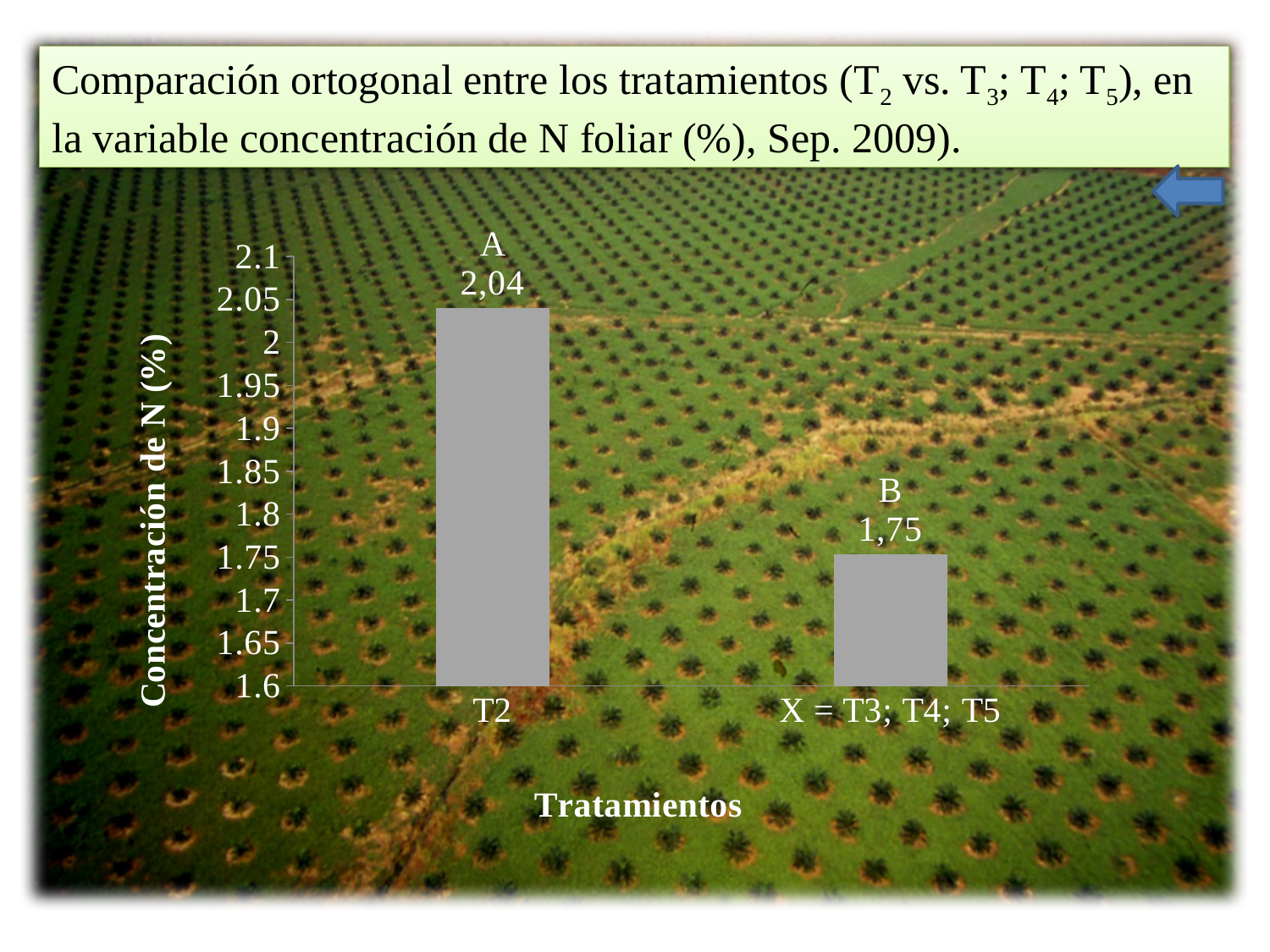
What is the label of the y axis? Concentración de N (%) How many treatment categories are shown on the x axis? 2 What letter is printed above the bar for X = T3; T4; T5? B What is the difference between the N concentration of T2 and X = T3; T4; T5? 0,29 Is the value for T2 greater or less than 2? greater What kind of chart is shown on the slide? Bar chart Is the value for X = T3; T4; T5 greater or less than 1.8? less Which treatment has the lowest N concentration? X = T3; T4; T5 What is the N concentration value for T2? 2,04 What is the N concentration value for X = T3; T4; T5? 1,75 Which has a larger N concentration, T2 or X = T3; T4; T5? T2 Which treatment has the highest N concentration? T2